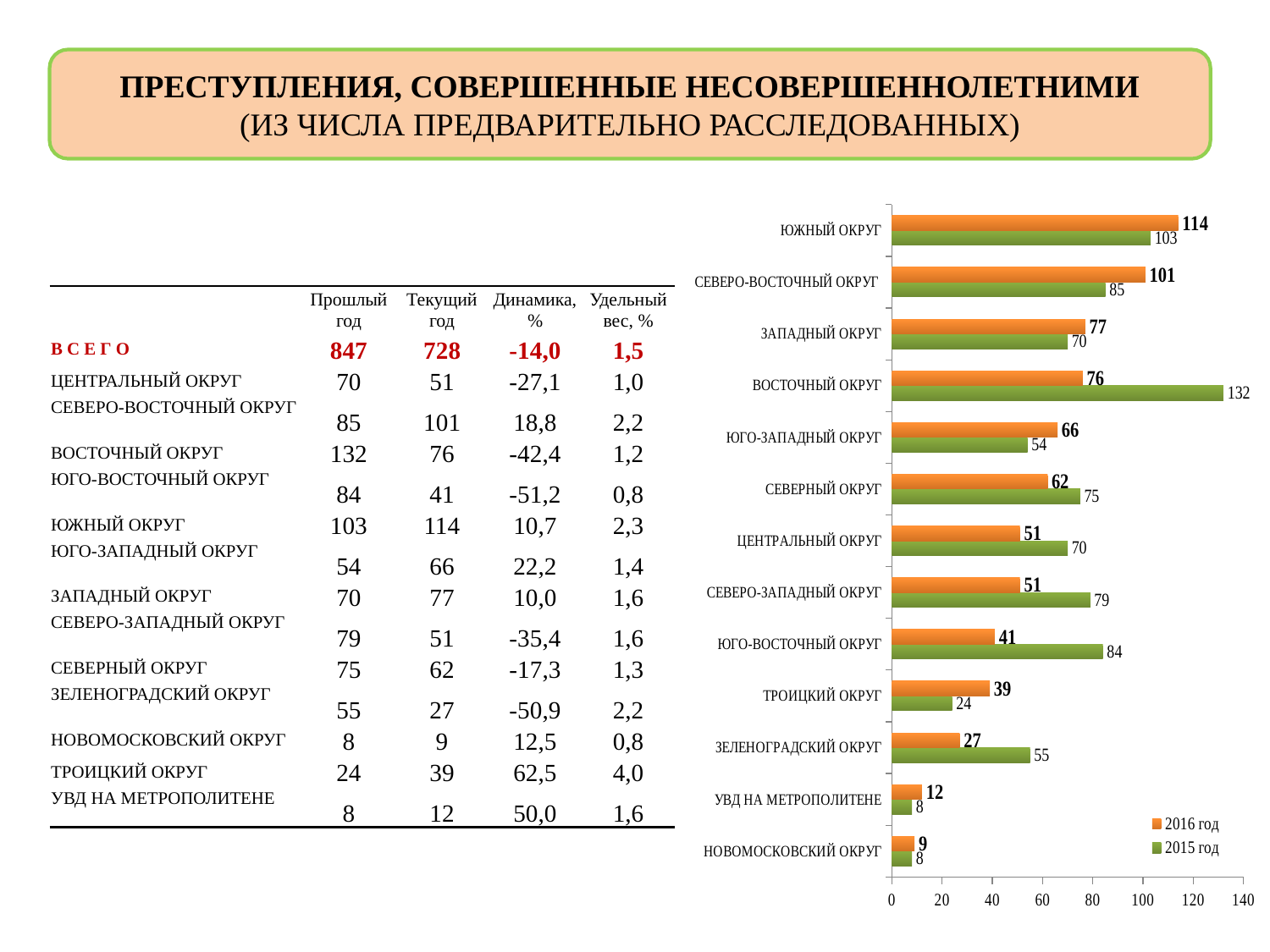
What type of chart is shown on the slide? bar chart Which district has the highest 2015 год value in the chart? ВОСТОЧНЫЙ ОКРУГ What is the difference between the 2015 год and 2016 год values for ЮГО-ВОСТОЧНЫЙ ОКРУГ? 43 How many series does the chart legend list? 2 Which colour represents the 2015 год series in the chart? green How many categories (districts) are plotted in the chart? 13 What is the 2016 год value for ТРОИЦКИЙ ОКРУГ in the chart? 39 Which district has the highest 2016 год value in the chart? ЮЖНЫЙ ОКРУГ What is the 2016 год value for ЮЖНЫЙ ОКРУГ in the chart? 114 What is the 2015 год value for ВОСТОЧНЫЙ ОКРУГ in the chart? 132 Which category has the lowest 2016 год value in the chart? НОВОМОСКОВСКИЙ ОКРУГ For СЕВЕРО-ВОСТОЧНЫЙ ОКРУГ, which is larger: the 2016 год value or the 2015 год value? 2016 год